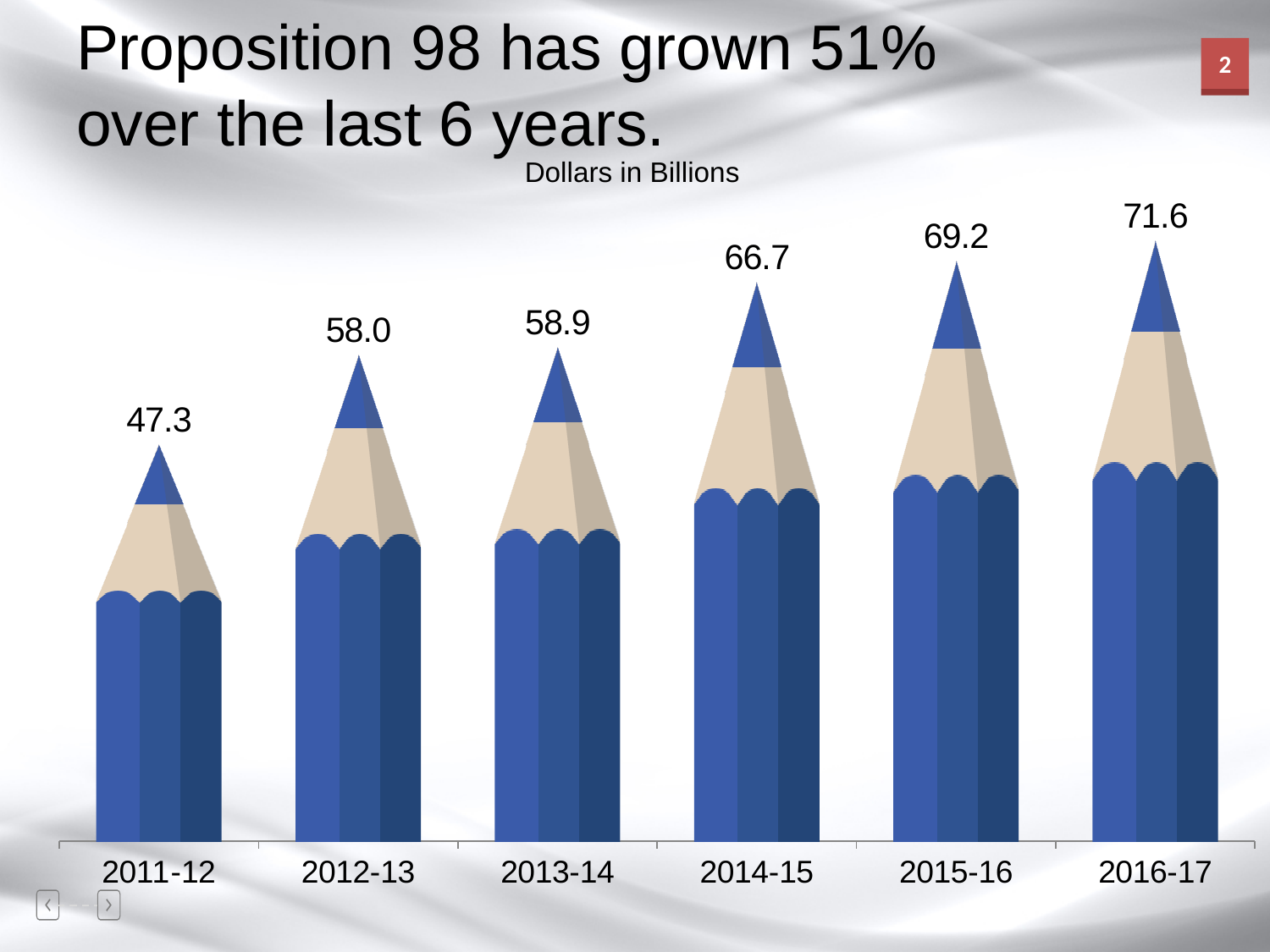
What is the value for 2016-17? 71.6 Which year has the highest value? 2016-17 What unit is stated for the values on the chart? Dollars in Billions Which year has the lowest value? 2011-12 Which is larger, the value for 2015-16 or the value for 2014-15? 2015-16 What is the difference between the values for 2013-14 and 2012-13? 0.9 What is the value for 2011-12? 47.3 Do the values rise or fall from 2011-12 to 2016-17? rise What is the difference between the values for 2016-17 and 2011-12? 24.3 How many years are shown on the chart? 6 What kind of chart is shown on the slide? bar chart What is the value for 2014-15? 66.7